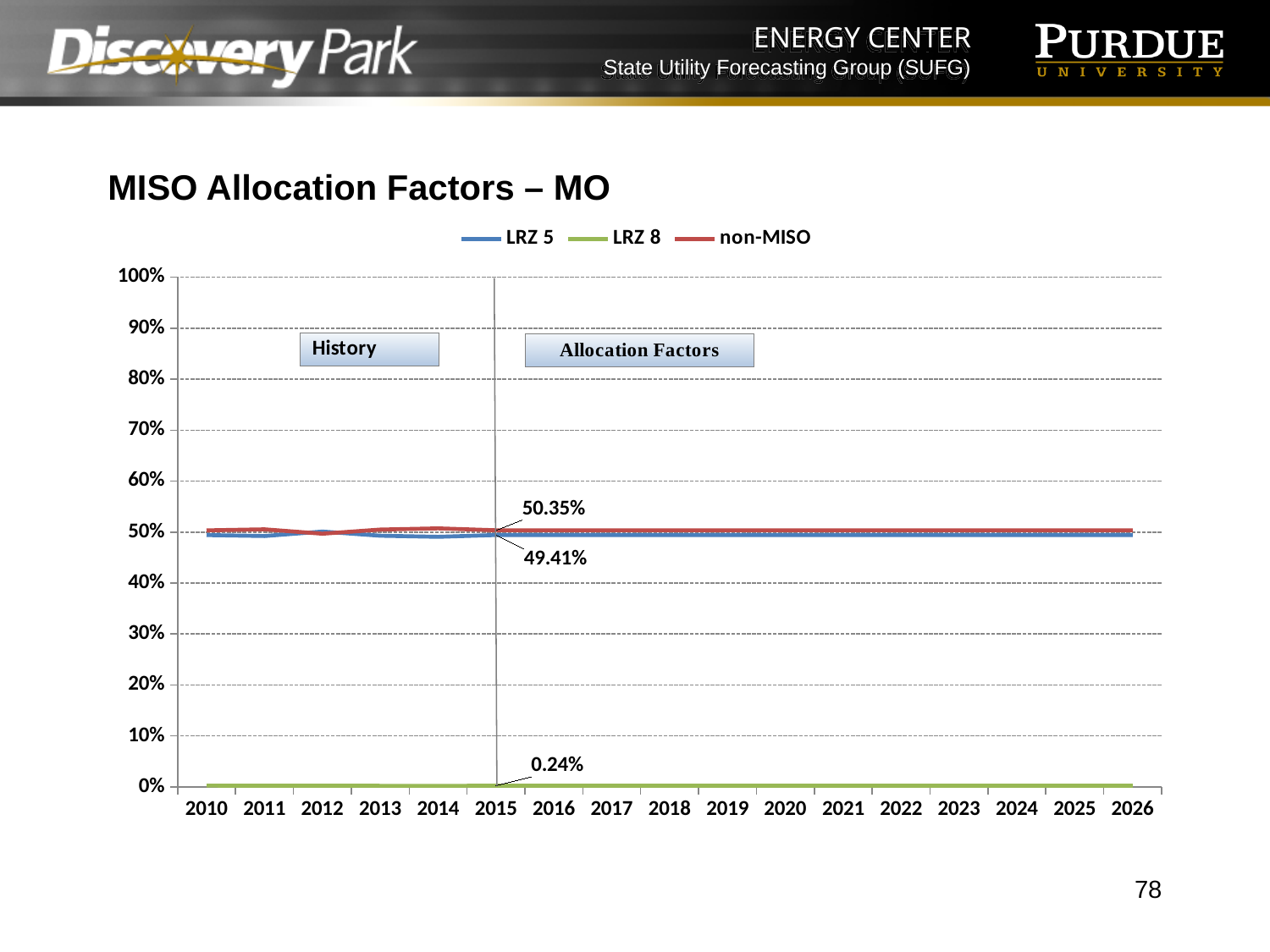
How many years are shown on the x axis? 17 What is the labeled value for LRZ 8 in 2015? 0.24% What is the labeled value for non-MISO in 2015? 50.35% Is the value for LRZ 8 in 2020 greater or less than 10%? less Which series has the lowest values across the chart? LRZ 8 What is the labeled value for LRZ 5 in 2015? 49.41% Which is larger in 2025, LRZ 5 or LRZ 8? LRZ 5 What type of chart is shown on the slide? line chart What is the difference between the labeled non-MISO value and the labeled LRZ 8 value in 2015? 50.11% Is the value for non-MISO in 2020 greater or less than 40%? greater How many series does the legend list? 3 What is the difference between the labeled non-MISO value and the labeled LRZ 5 value in 2015? 0.94%